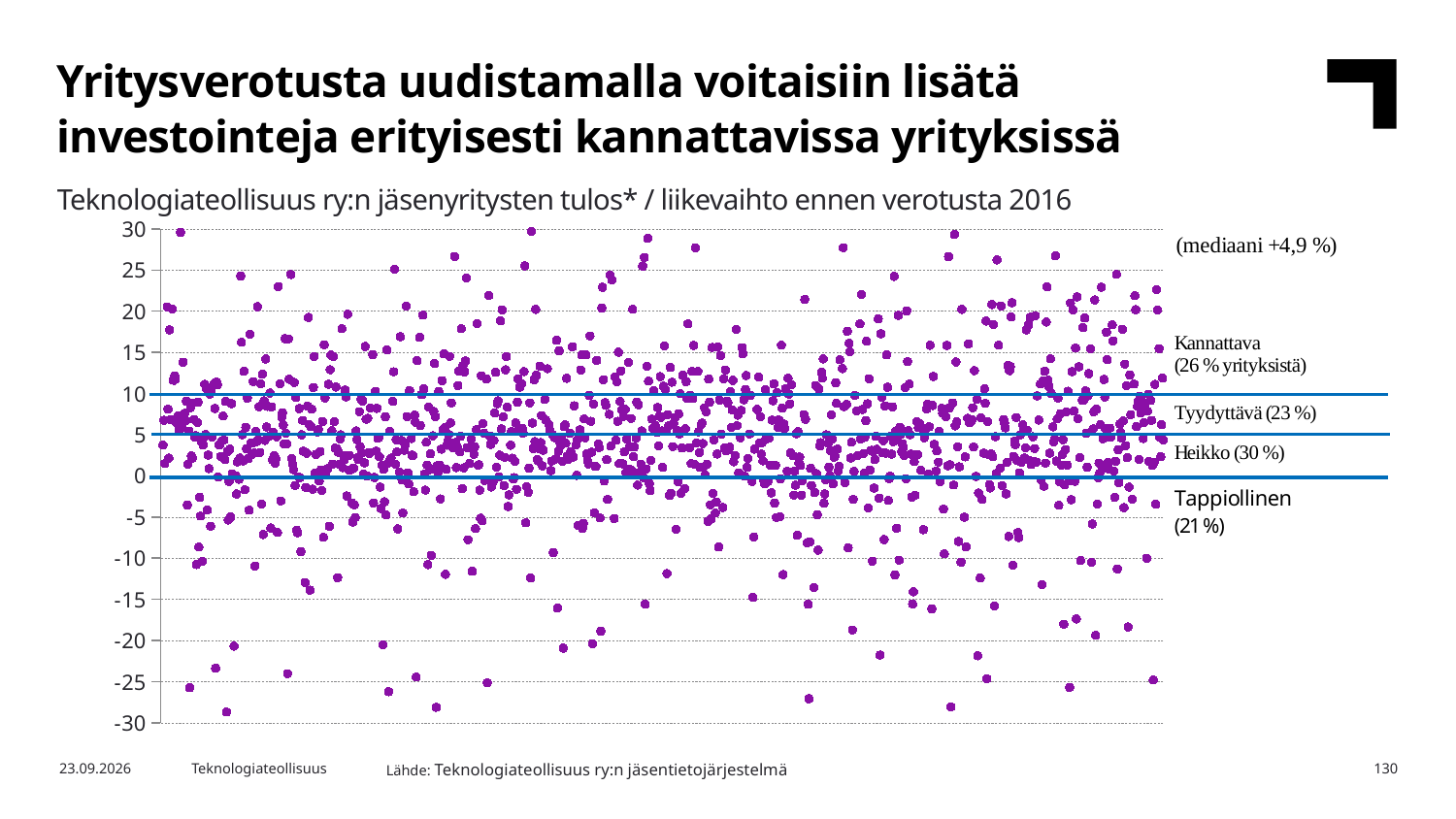
What share of companies is labelled as Tyydyttävä? 23 % Which of the four profitability groups has the largest share of companies? Heikko What is the median value (mediaani) stated on the chart? +4,9 % What share of companies is labelled as Kannattava? 26 % What is the highest value shown on the vertical axis? 30 Which group has a larger share of companies, Kannattava or Tyydyttävä? Kannattava Which of the four profitability groups has the smallest share of companies? Tappiollinen What share of companies is labelled as Tappiollinen? 21 % What is the difference in percentage points between the Kannattava share and the Tappiollinen share? 5 What kind of chart is shown on the slide? Scatter chart What is the title of the chart? Teknologiateollisuus ry:n jäsenyritysten tulos* / liikevaihto ennen verotusta 2016 What share of companies is labelled as Heikko? 30 %